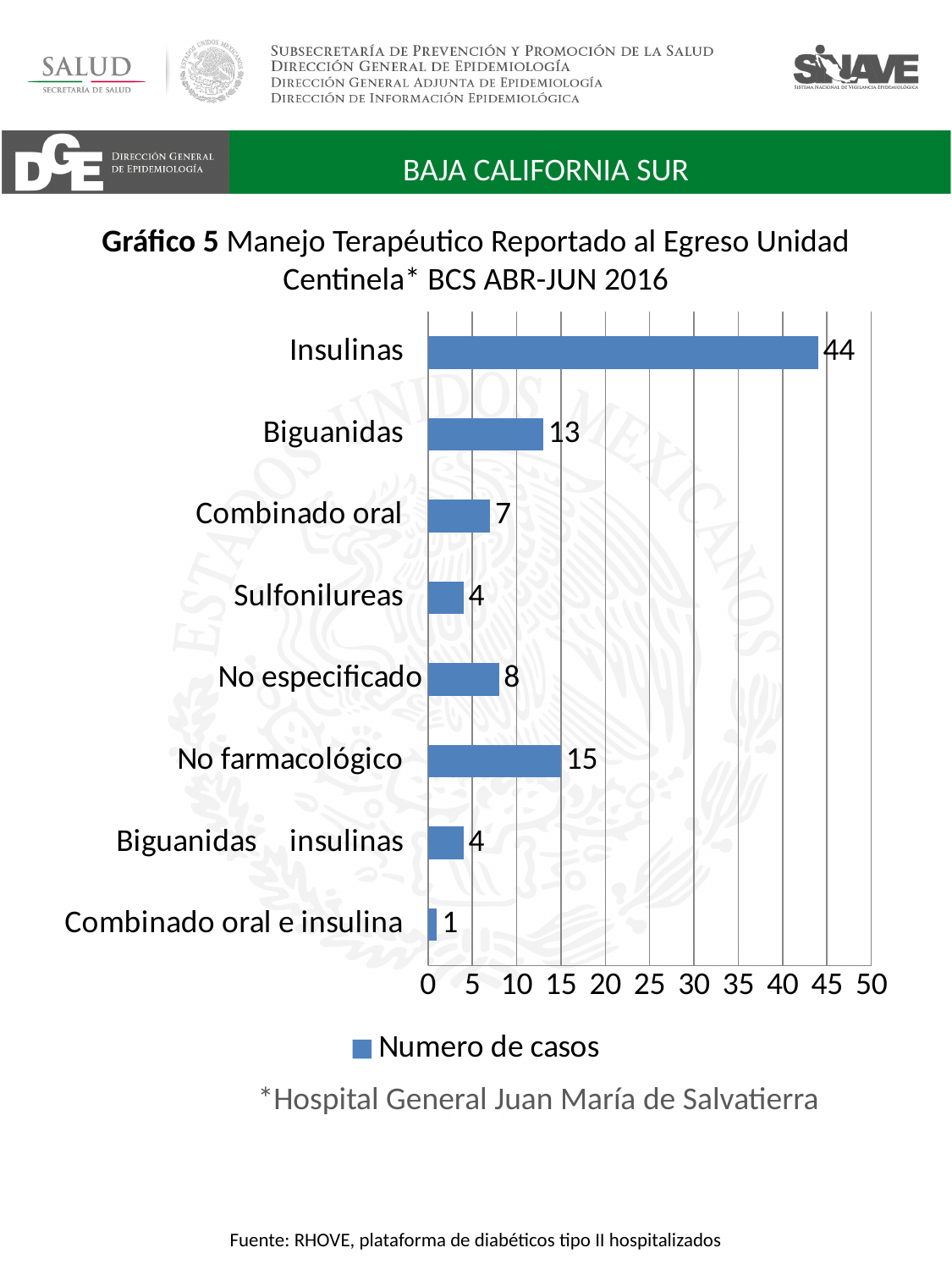
What is the difference between the values for Insulinas and Biguanidas? 31 Is the value for Insulinas greater or less than 40? greater What kind of chart is shown on the slide? bar chart How many categories are shown in the chart? 8 What is the value for No farmacológico? 15 What is the value for Combinado oral e insulina? 1 What is the legend entry for the series shown in the chart? Numero de casos Which is larger, the value for No farmacológico or the value for Biguanidas? No farmacológico How many series does the legend list? 1 What is the value for Insulinas? 44 Which category has the highest number of cases? Insulinas Which category has the lowest number of cases? Combinado oral e insulina